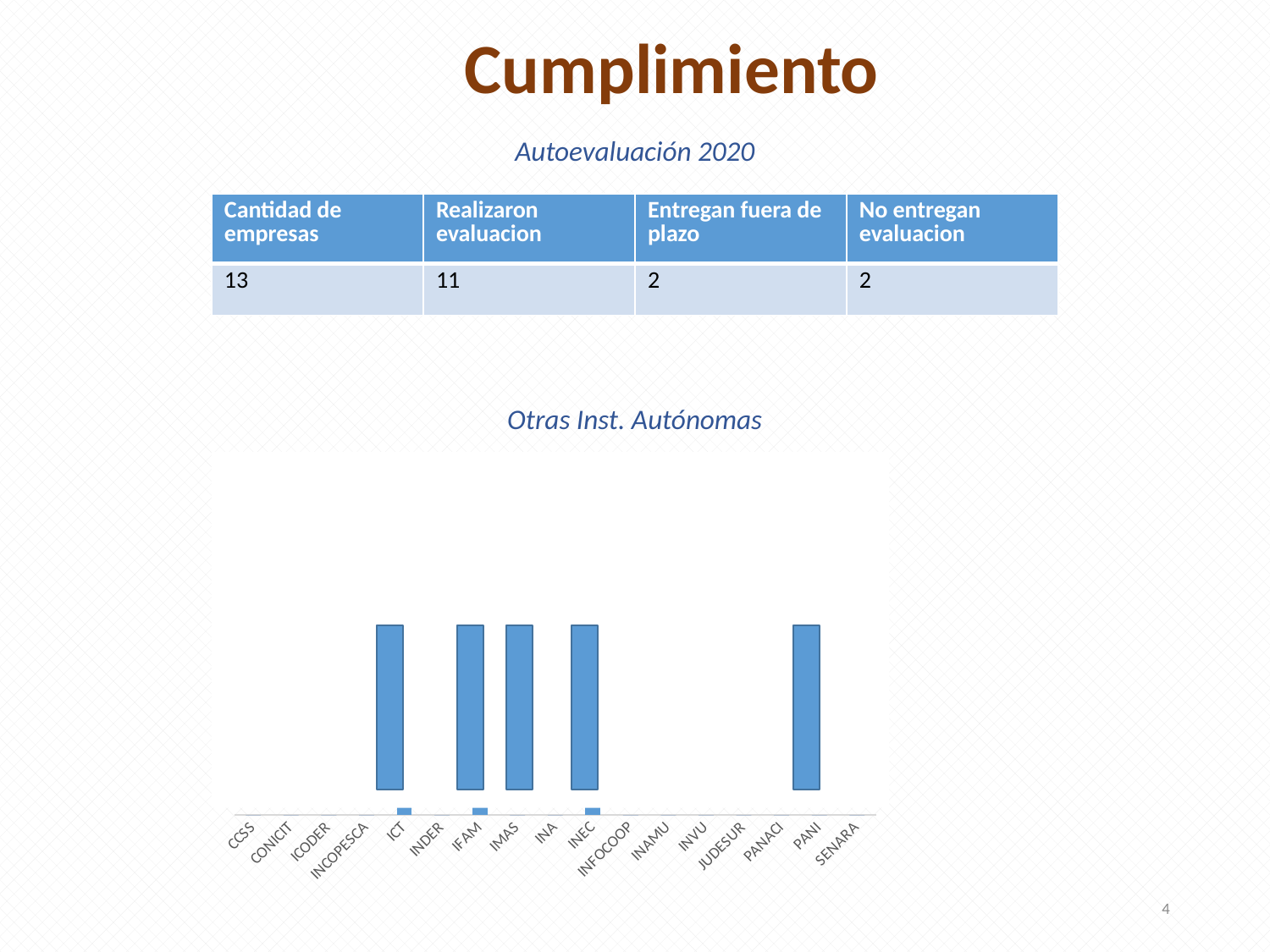
What is the title shown above the chart? Otras Inst. Autónomas Which is larger in the chart, the bar for IFAM or the bar for JUDESUR? IFAM How many categories are listed along the x axis of the chart? 17 Which is larger in the chart, the bar for ICT or the bar for CCSS? ICT Which is larger in the chart, the bar for IMAS or the bar for INA? IMAS What is the last category on the x axis of the chart? SENARA What kind of chart is shown on the slide? bar chart Which categories in the chart have tall bars? ICT, IFAM, IMAS, INEC, PANI How many categories in the chart have a tall bar? 5 What is the first category on the x axis of the chart? CCSS